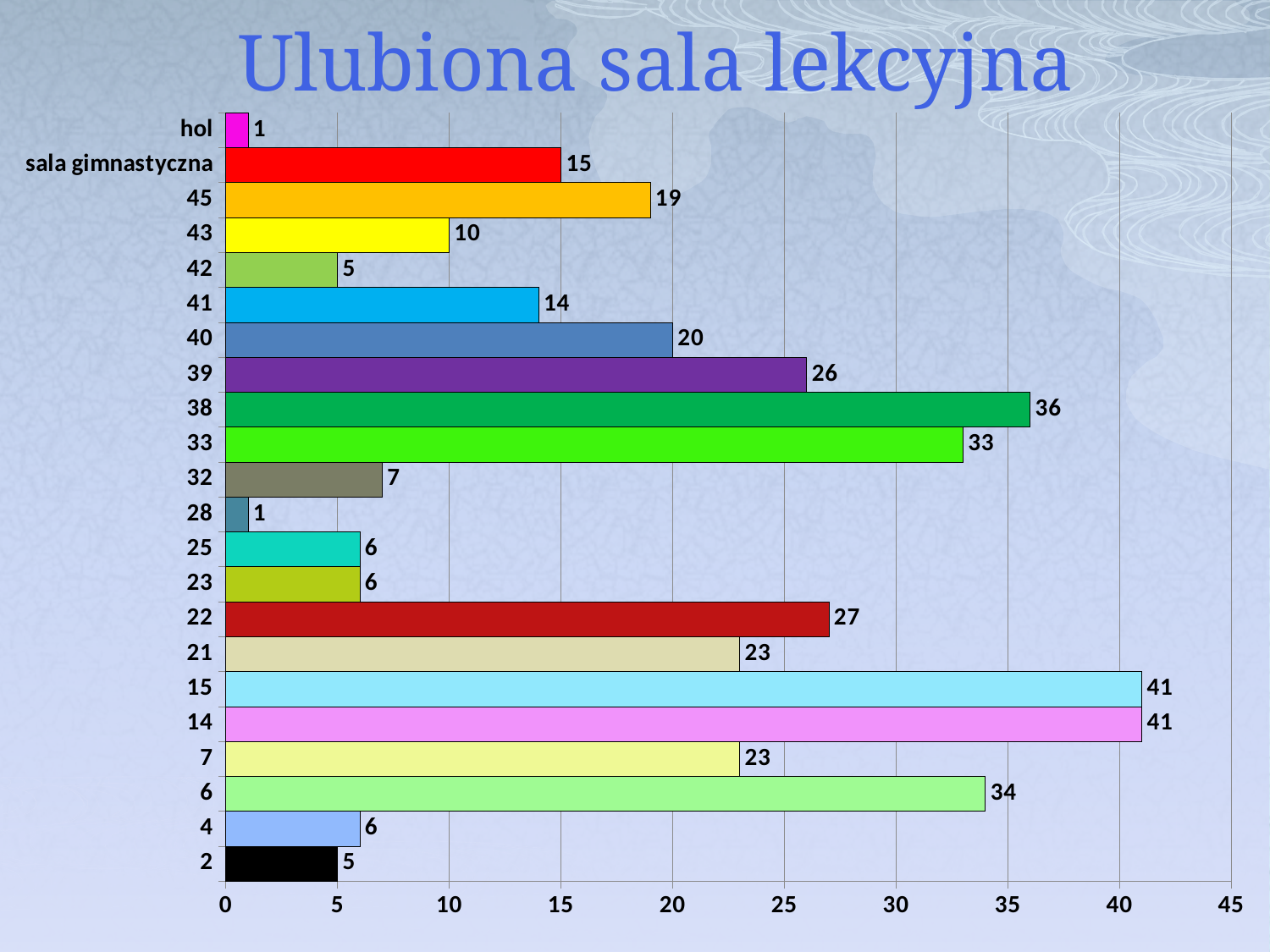
What is the value for hol? 1 What is the value for category 38? 36 What is the value for sala gimnastyczna? 15 What is the difference between the values for category 38 and category 33? 3 What is the value for category 22? 27 How many categories are shown on the chart? 22 What is the difference between the values for category 22 and category 21? 4 What is the value for category 6? 34 What is the highest value shown on the chart? 41 What kind of chart is shown on the slide? bar chart Is the value for category 39 greater or less than 25? greater Which has a larger value, category 40 or category 41? 40